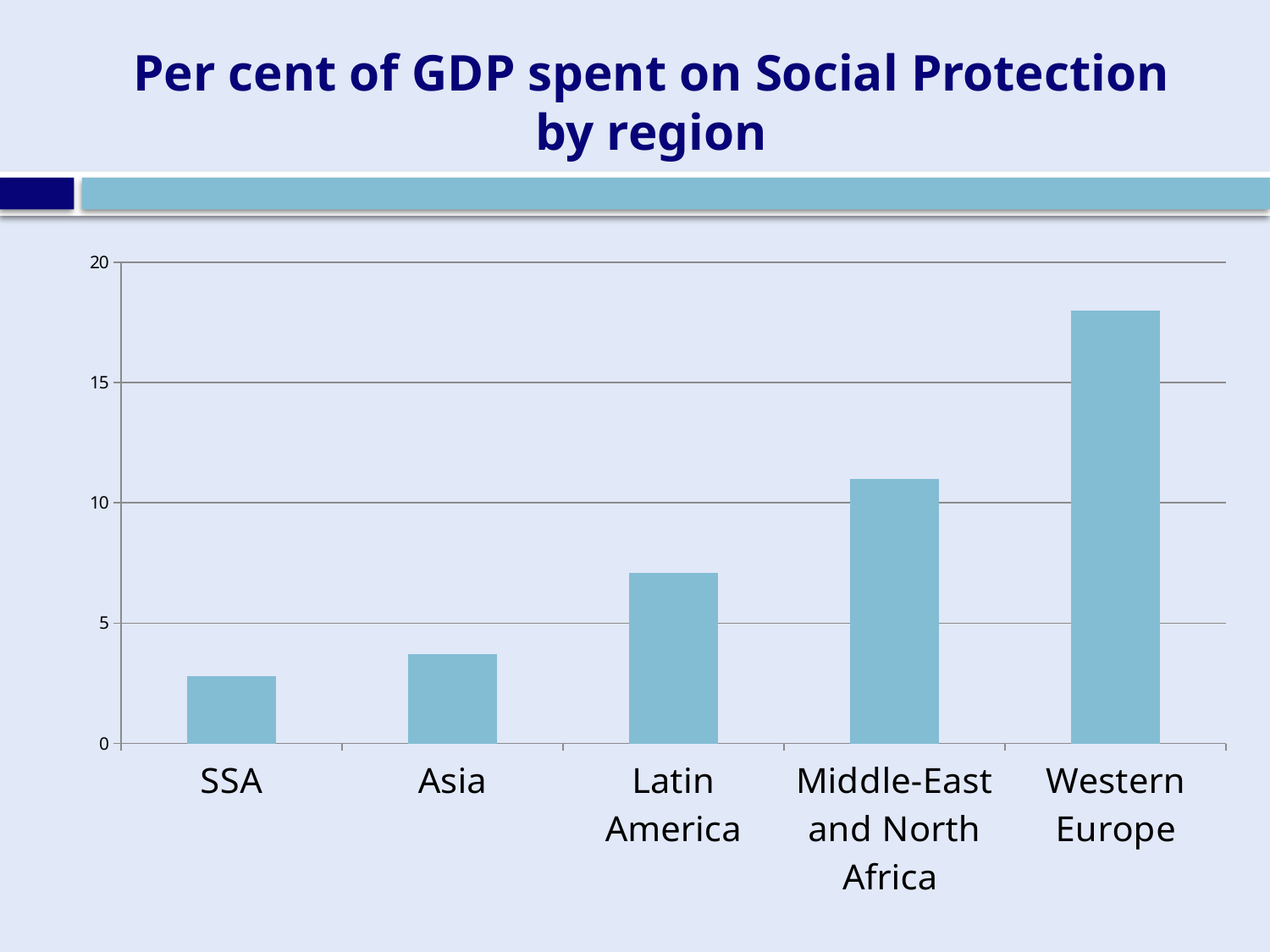
What kind of chart is shown on the slide? bar chart Which is larger, the value for Asia or the value for Middle-East and North Africa? Middle-East and North Africa Is the value for Latin America greater or less than 5? greater Is the value for Latin America greater or less than 10? less What is the title of the chart on the slide? Per cent of GDP spent on Social Protection by region How many regions are shown on the x axis of the chart? 5 Is the value for SSA greater or less than 5? less Which region has the highest per cent of GDP spent on social protection? Western Europe Which region has the lowest per cent of GDP spent on social protection? SSA Do the values rise or fall moving from left to right along the x axis? rise